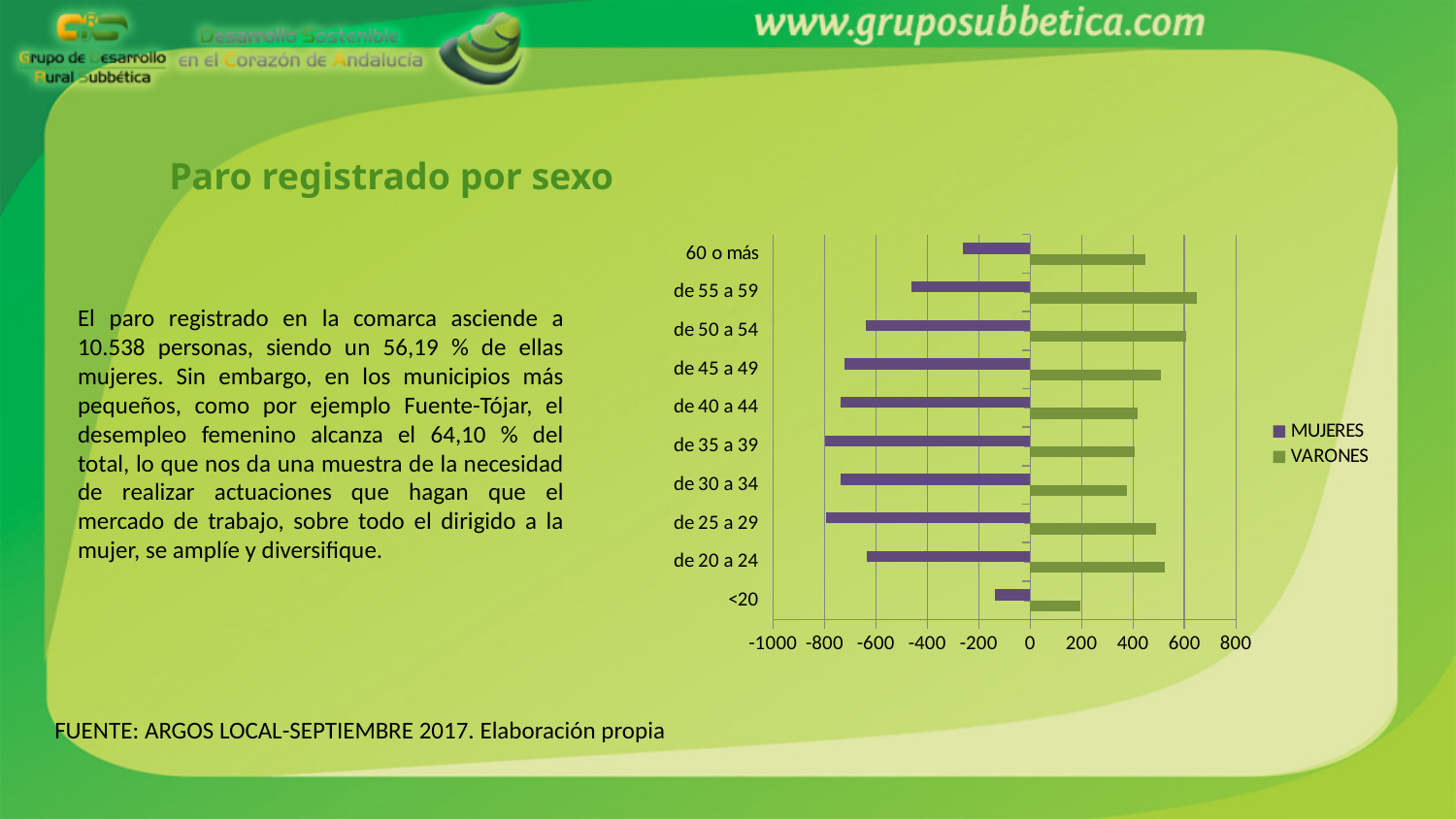
How many series does the chart legend list? 2 Which age group has the highest VARONES value? de 55 a 59 Is the MUJERES value for de 35 a 39 greater or less than -600? less Which is larger, the VARONES value for de 20 a 24 or for de 30 a 34? de 20 a 24 On which side of the zero line are the MUJERES bars plotted? the negative (left) side Is the VARONES value for <20 greater or less than 400? less Which age group has the shortest MUJERES bar? <20 What kind of chart is shown on the slide? bar chart Which age group has the lowest VARONES value? <20 Is the VARONES value for de 55 a 59 greater or less than 600? greater How many age-group categories are plotted on the chart? 10 What are the two series named in the chart legend? MUJERES and VARONES